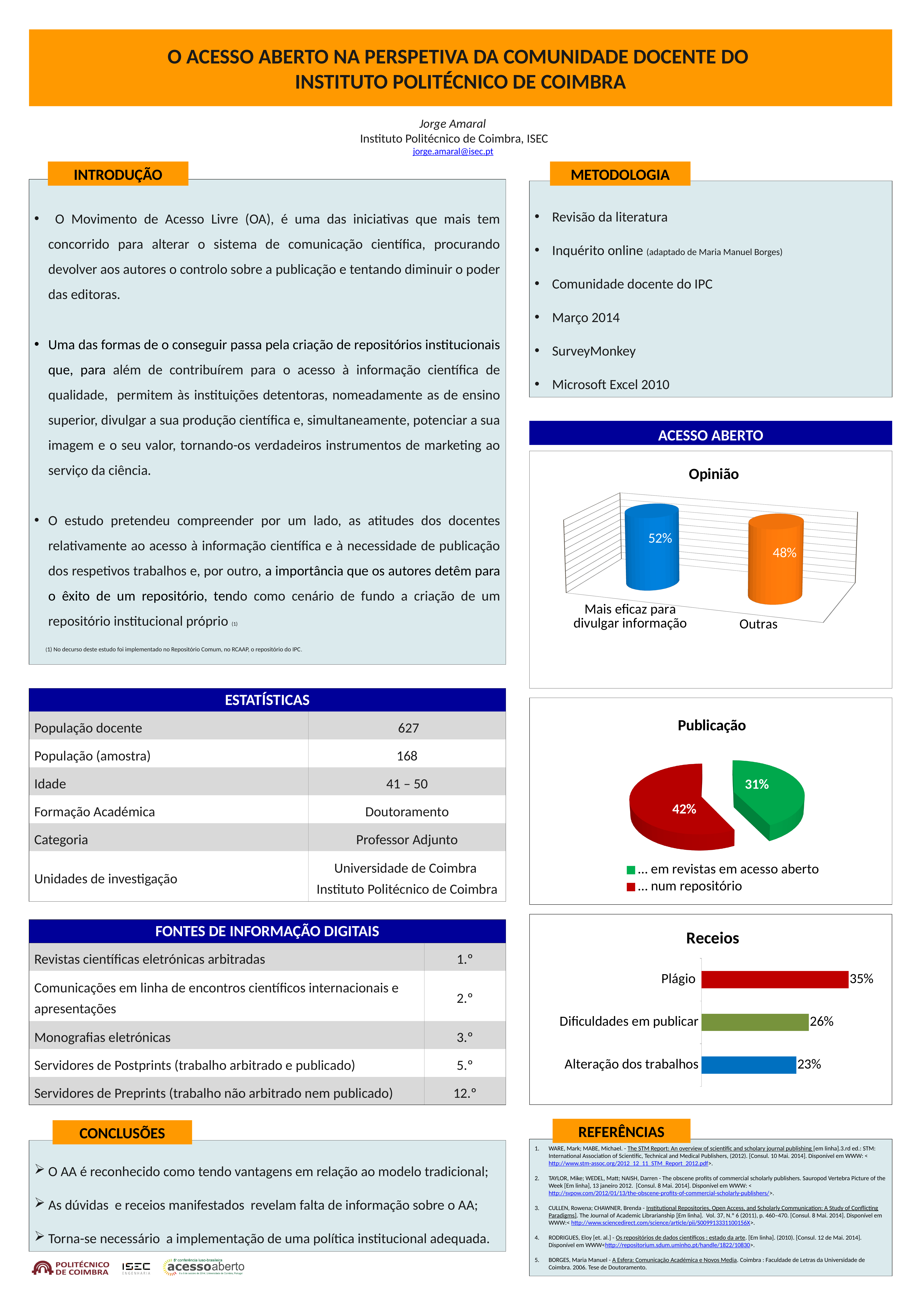
In the "Publicação" chart, what share is shown for "... num repositório"? 42% In the "Publicação" chart, how many entries does the legend list? 2 In the "Opinião" chart, what is the difference between the two values? 4% In the "Receios" chart, what is the value for "Plágio"? 35% In the "Opinião" chart, which category has the higher value? Mais eficaz para divulgar informação In the "Opinião" chart, what is the value for "Outras"? 48% What kind of chart is the "Receios" chart? Bar chart In the "Publicação" chart, what share is shown for "... em revistas em acesso aberto"? 31% What kind of chart is the "Publicação" chart? Pie chart In the "Receios" chart, what is the difference between "Plágio" and "Dificuldades em publicar"? 9% In the "Receios" chart, which category has the lowest value? Alteração dos trabalhos In the "Opinião" chart, what is the value for "Mais eficaz para divulgar informação"? 52%